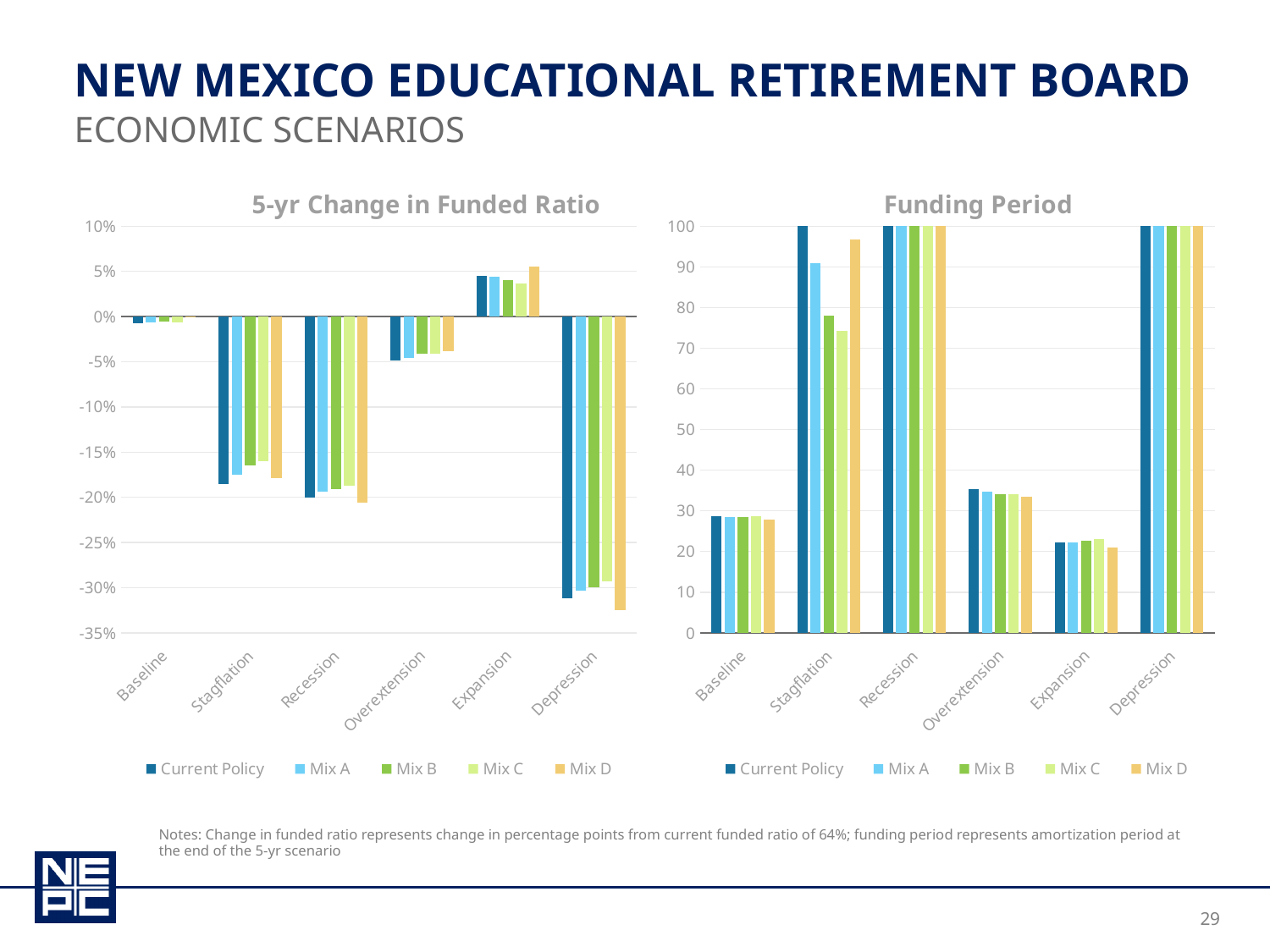
In the 'Funding Period' chart, what is the Mix D value for Depression? 100 How many series does the legend of the 'Funding Period' chart list? 5 What kind of chart is the '5-yr Change in Funded Ratio' chart? bar chart In the 'Funding Period' chart, is the Mix C value for Stagflation greater or less than 80? less In the 'Funding Period' chart, is the Current Policy value for Overextension greater or less than 30? greater How many economic scenarios are shown on the x axis of the '5-yr Change in Funded Ratio' chart? 6 In the 'Funding Period' chart, what is the Current Policy value for Recession? 100 In the '5-yr Change in Funded Ratio' chart, which scenario is the only one with positive values? Expansion In the 'Funding Period' chart, which scenario has the lowest funding period? Expansion In the '5-yr Change in Funded Ratio' chart, is the Mix D value for Depression greater or less than -30%? less In the '5-yr Change in Funded Ratio' chart, which scenario has the lowest values? Depression